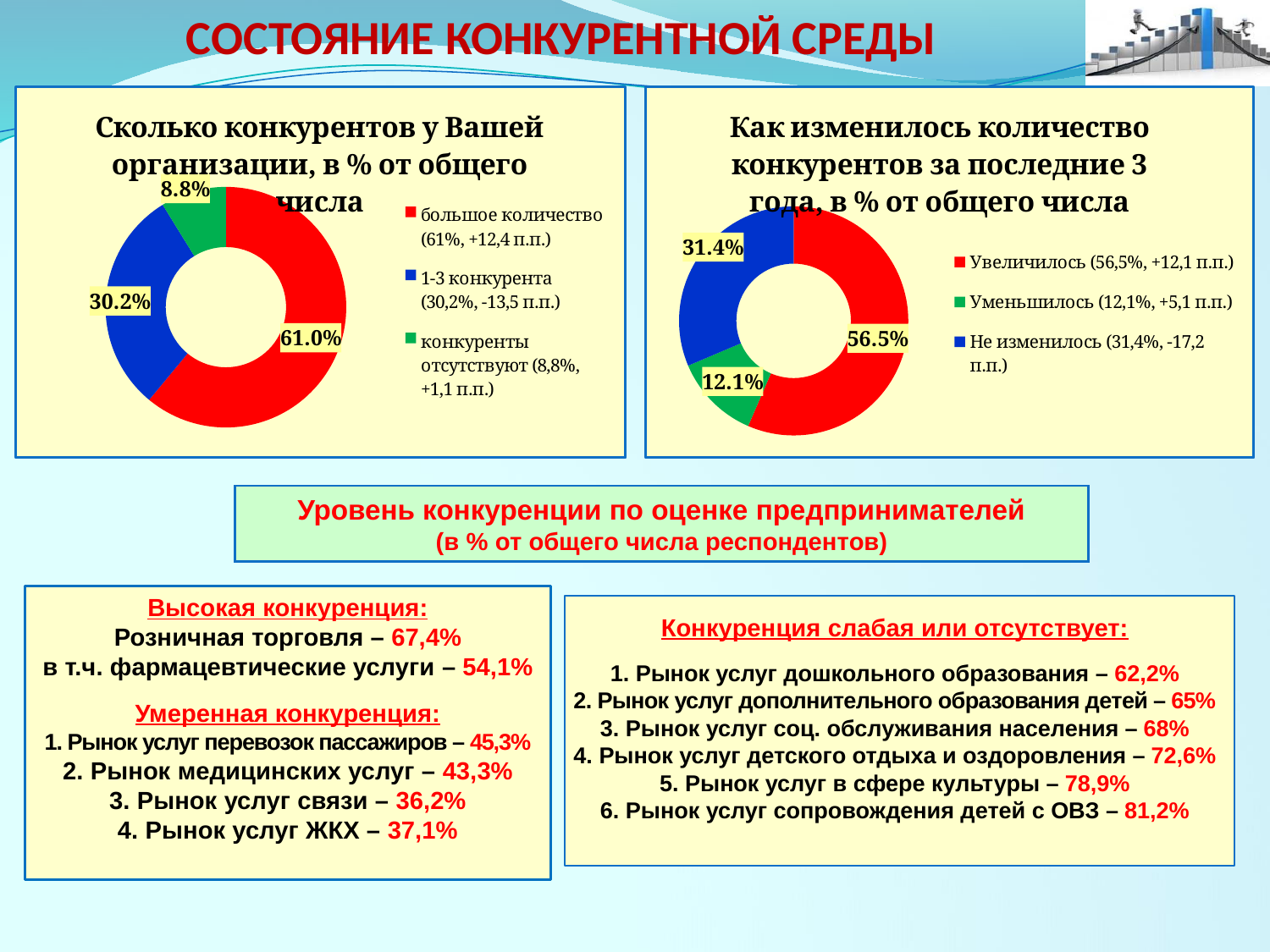
In the right chart (Как изменилось количество конкурентов за последние 3 года), which category has the smallest share? Уменьшилось In the left chart (Сколько конкурентов у Вашей организации), how many percentage points larger is «большое количество» than «1-3 конкурента»? 30.8 In the right chart (Как изменилось количество конкурентов за последние 3 года), what is the value for «Не изменилось»? 31.4% In the left chart (Сколько конкурентов у Вашей организации), what is the value for «большое количество»? 61.0% In the left chart (Сколько конкурентов у Вашей организации), what is the value for «1-3 конкурента»? 30.2% In the left chart (Сколько конкурентов у Вашей организации), which category has the largest share? большое количество In the right chart (Как изменилось количество конкурентов за последние 3 года), which is larger: «Не изменилось» or «Уменьшилось»? Не изменилось In the right chart (Как изменилось количество конкурентов за последние 3 года), how many percentage points larger is «Увеличилось» than «Не изменилось»? 25.1 In the right chart (Как изменилось количество конкурентов за последние 3 года), what is the value for «Увеличилось»? 56.5% In the left chart (Сколько конкурентов у Вашей организации), what is the value for «конкуренты отсутствуют»? 8.8% In the left chart (Сколько конкурентов у Вашей организации), which category has the smallest share? конкуренты отсутствуют How many categories does the legend of the right chart (Как изменилось количество конкурентов за последние 3 года) list? 3